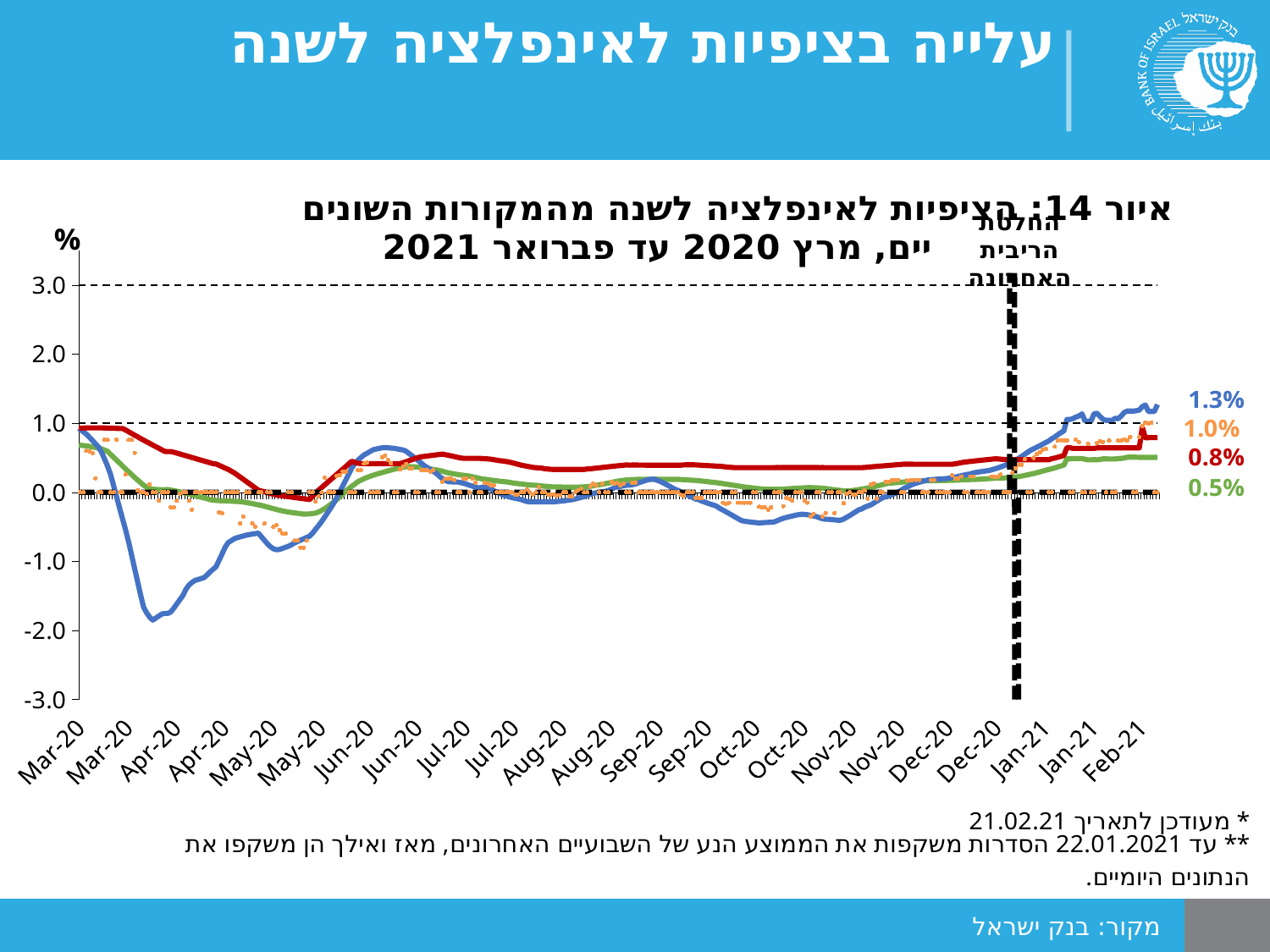
Is the lowest point of the blue line, around April 2020, greater or less than -1.0? less What is the highest value shown on the vertical axis? 3.0 Which line has the highest labelled value at the end of the chart? the blue line (1.3%) What is the difference between the end values of the blue line (1.3%) and the green line (0.5%)? 0.8% Does the blue line rise or fall between December 2020 and February 2021? rise What is the final value labelled for the blue line at the right end of the chart? 1.3% What is the final value labelled for the green line at the right end of the chart? 0.5% Which line has the lowest labelled value at the end of the chart? the green line (0.5%) How many lines are plotted on the chart? 4 What kind of chart is shown on the slide? line chart What is the final value labelled for the orange dotted line at the right end of the chart? 1.0% What is the final value labelled for the red line at the right end of the chart? 0.8%